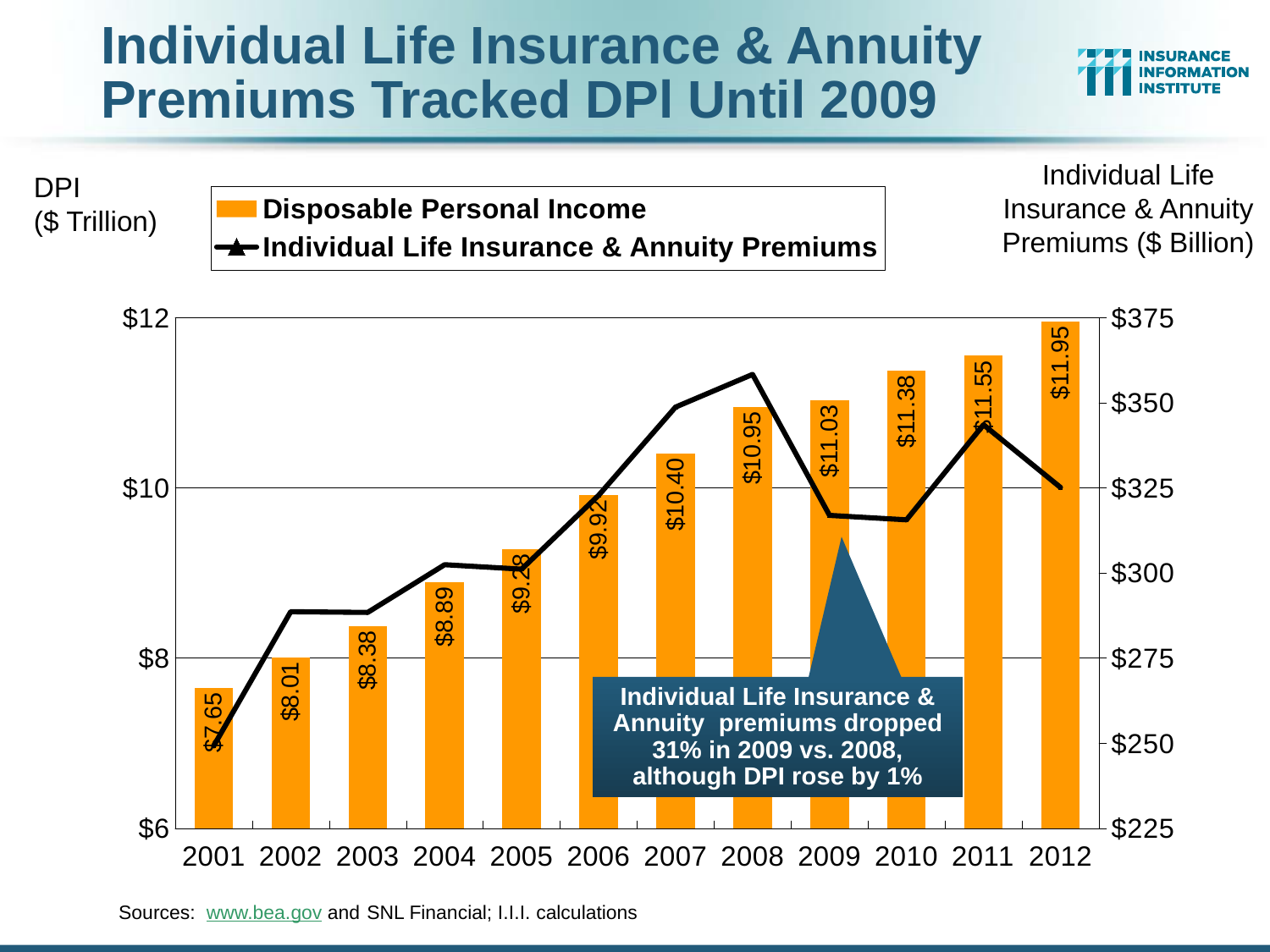
Which year had higher Disposable Personal Income, 2009 or 2008? 2009 How many years are shown on the x axis? 12 What was Disposable Personal Income in 2008? $10.95 By how much did Disposable Personal Income increase from 2001 to 2012? $4.30 What is the overall trend of Disposable Personal Income from 2001 to 2012? Rising Is the value for Individual Life Insurance & Annuity Premiums in 2001 greater or less than $275? less How many series does the legend list? 2 Is the value for Individual Life Insurance & Annuity Premiums in 2007 greater or less than $325? greater In which year was Disposable Personal Income highest? 2012 What was Disposable Personal Income in 2001? $7.65 In which year were Individual Life Insurance & Annuity Premiums highest? 2008 In which year was Disposable Personal Income lowest? 2001